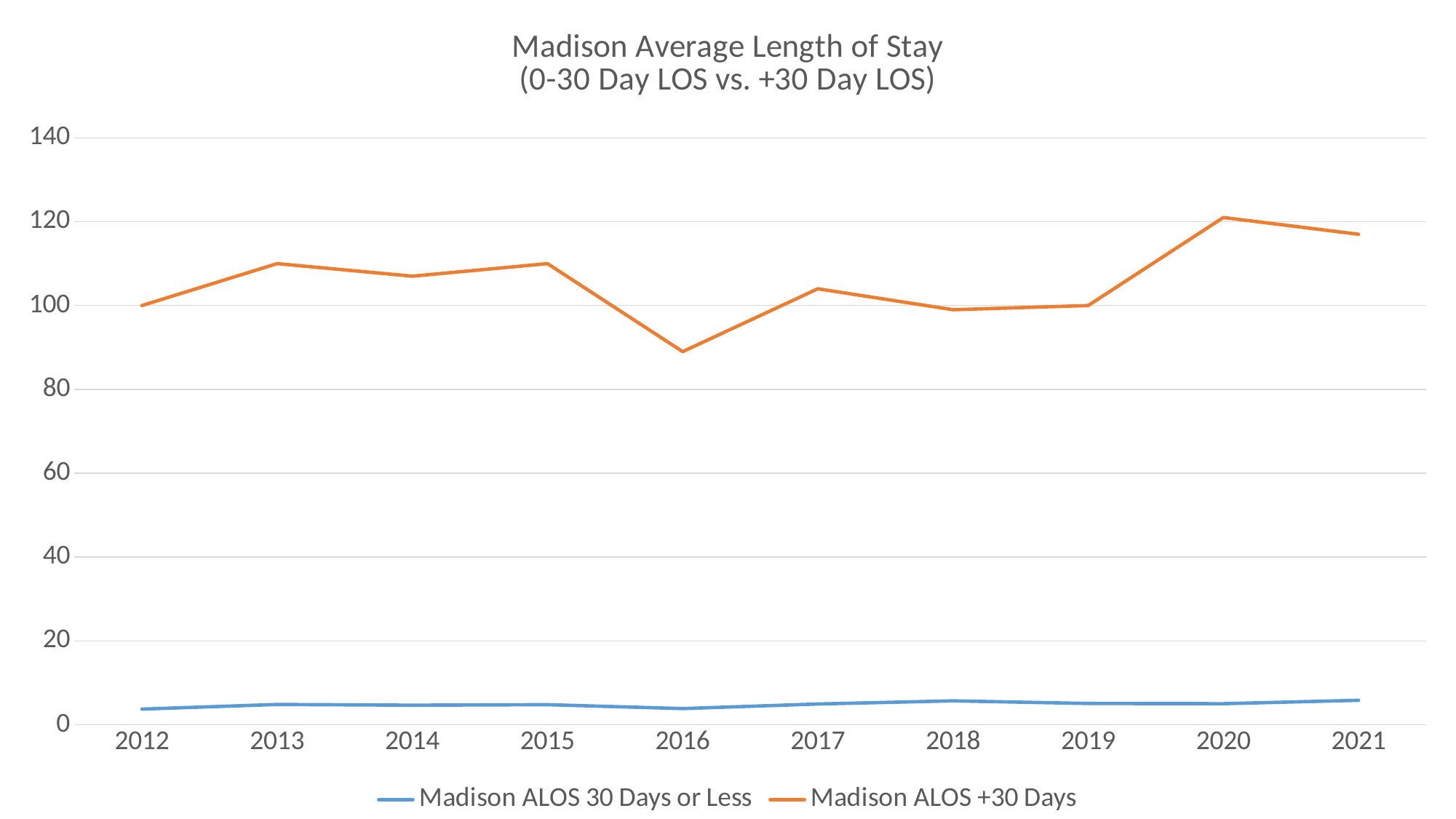
What kind of chart is shown on the slide? line chart How many years are shown along the x axis? 10 Is the Madison ALOS +30 Days value for 2020 greater or less than 110? greater In which year is the Madison ALOS +30 Days value highest? 2020 How many series does the legend list? 2 What is the title of the chart? Madison Average Length of Stay (0-30 Day LOS vs. +30 Day LOS) Is the Madison ALOS 30 Days or Less value for 2021 greater or less than 20? less For Madison ALOS +30 Days, which year has the larger value, 2013 or 2016? 2013 In which year is the Madison ALOS +30 Days value lowest? 2016 In 2018, which series has the higher value, Madison ALOS 30 Days or Less or Madison ALOS +30 Days? Madison ALOS +30 Days Does the Madison ALOS +30 Days line rise or fall from 2019 to 2020? rise Is the Madison ALOS +30 Days value for 2016 greater or less than 100? less